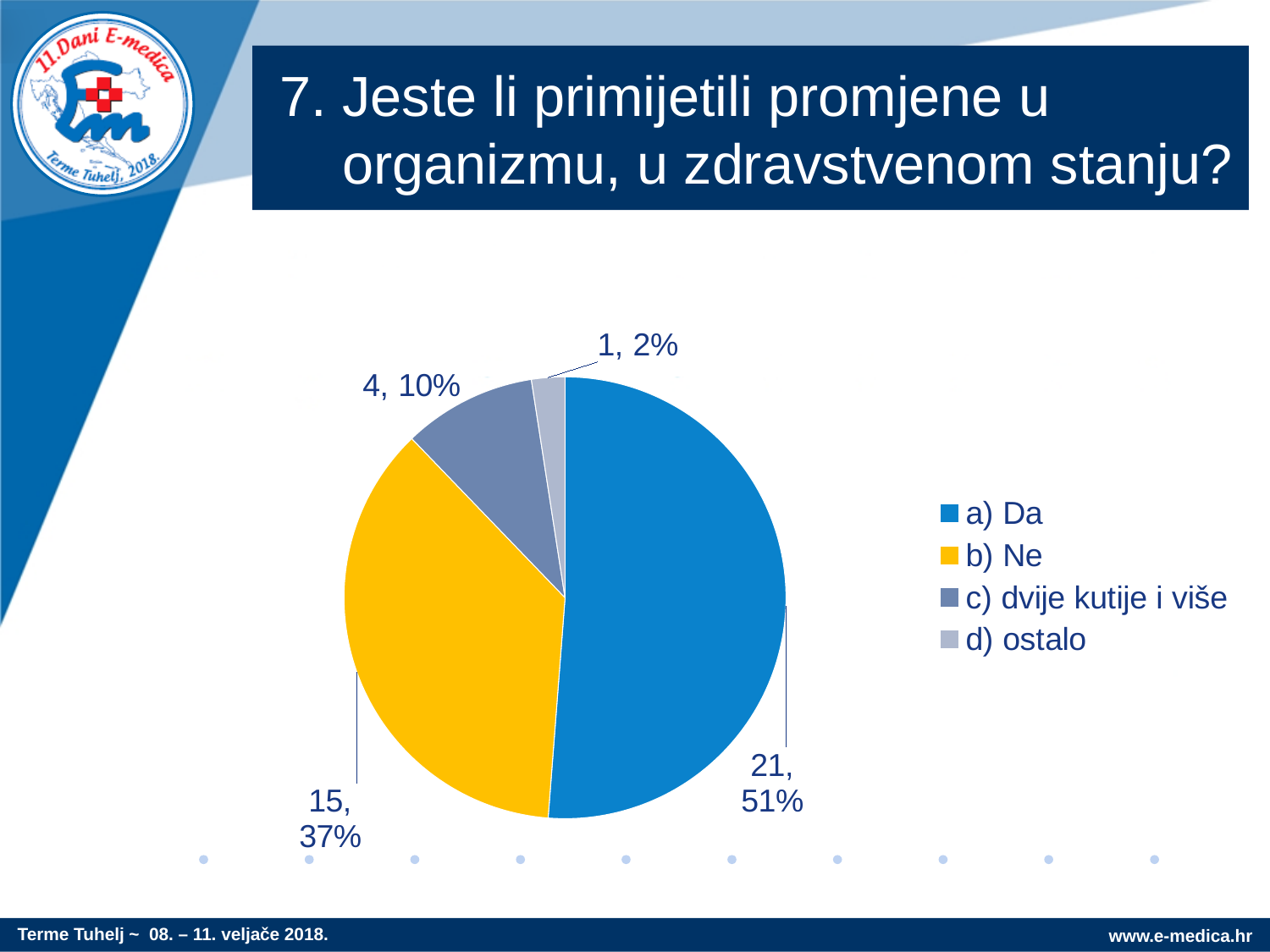
How many slices does the pie chart have? 4 What percentage share does the slice "b) Ne" have? 37% What percentage share does the slice "d) ostalo" have? 2% What kind of chart is shown on the slide? pie chart Which category has the largest slice of the pie? a) Da What colour is the slice for "b) Ne"? yellow How many entries does the legend list? 4 Which is larger, the slice for "c) dvije kutije i više" or the slice for "d) ostalo"? c) dvije kutije i više Which category has the smallest slice of the pie? d) ostalo What count is shown for the slice "a) Da"? 21 What count is shown for the slice "c) dvije kutije i više"? 4 What is the difference in count between "a) Da" and "b) Ne"? 6